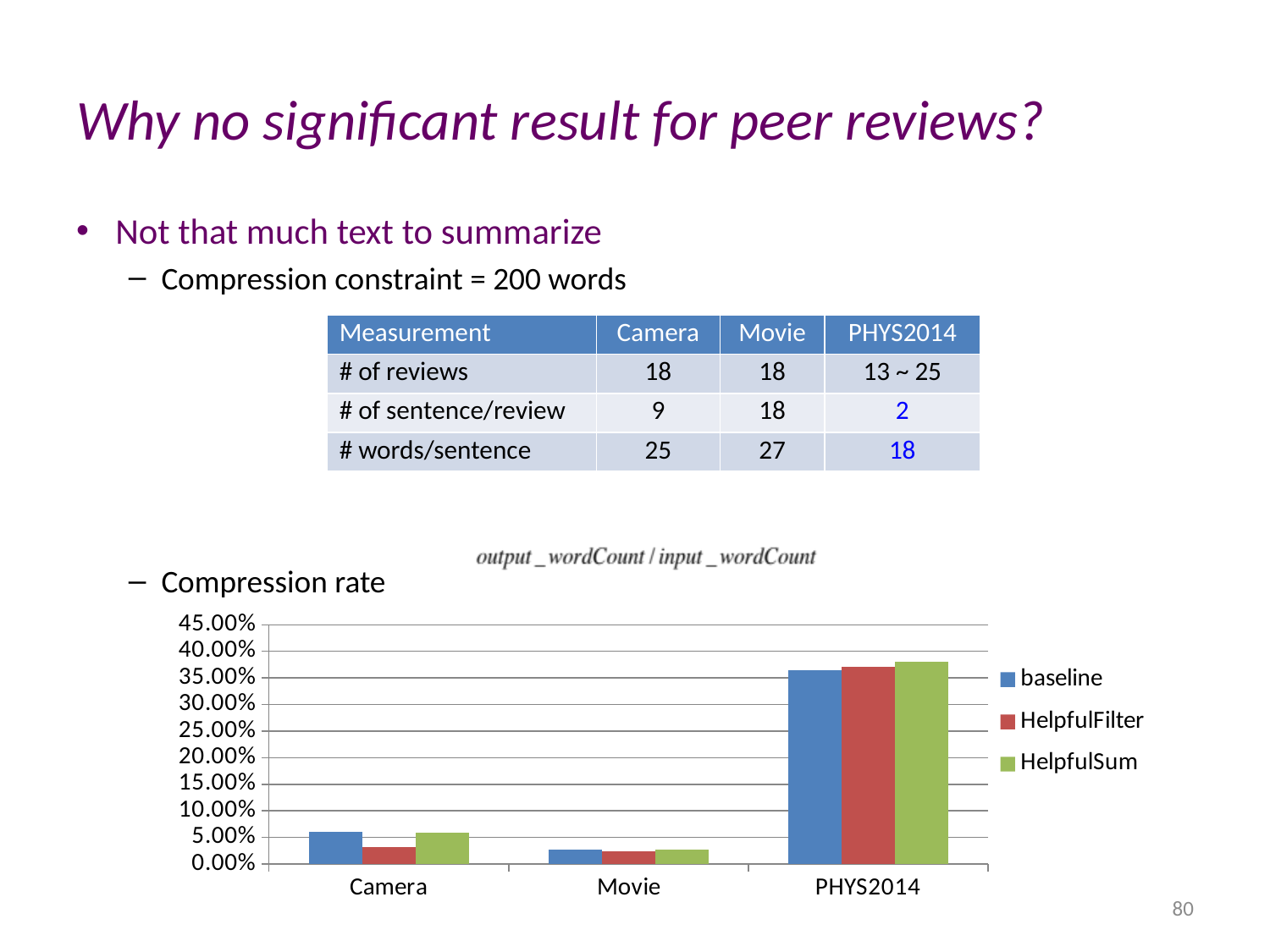
Is the HelpfulSum value for PHYS2014 greater or less than 35.00%? greater What kind of chart is shown on the slide? bar chart Is the baseline value for Camera greater or less than 10.00%? less For Camera, which is larger: the baseline value or the HelpfulFilter value? baseline Which category has the highest baseline value in the chart? PHYS2014 Which category has the lowest HelpfulSum value in the chart? Movie Which is larger: the baseline value for PHYS2014 or the baseline value for Movie? PHYS2014 What are the three series names listed in the chart's legend? baseline, HelpfulFilter, HelpfulSum Is the HelpfulSum value for Movie greater or less than 5.00%? less How many series does the chart's legend list? 3 How many categories are shown on the x axis of the chart? 3